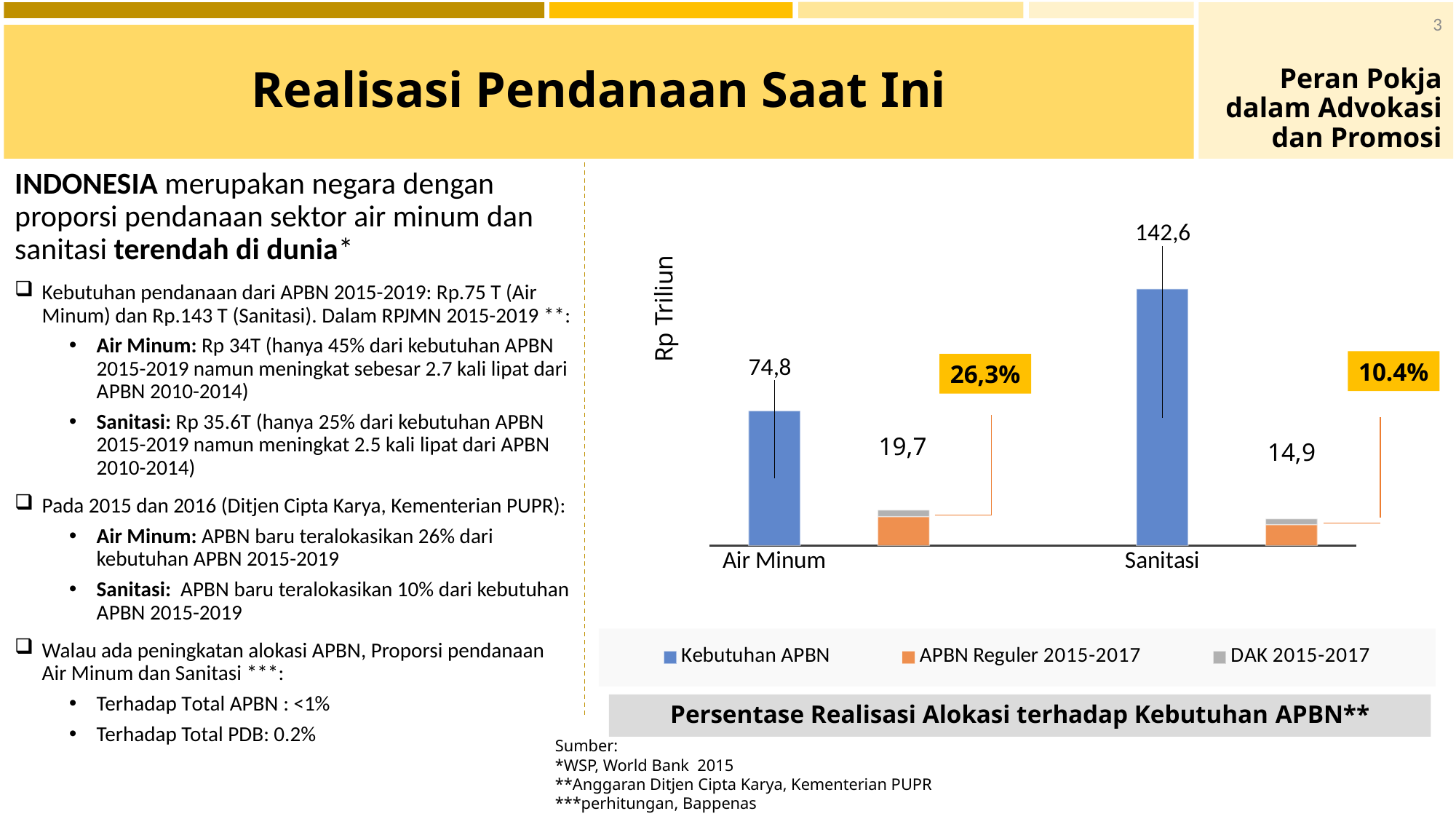
Which category has the lowest Kebutuhan APBN value? Air Minum Which series is shown in blue in the legend? Kebutuhan APBN What is the Kebutuhan APBN value for Sanitasi? 142,6 How many series does the legend list? 3 How many categories are shown on the x axis? 2 What is the difference between the Kebutuhan APBN values for Sanitasi and Air Minum? 67,8 What is the Kebutuhan APBN value for Air Minum? 74,8 What percentage is shown in the highlighted box next to the Sanitasi bars? 10.4% What percentage is shown in the highlighted box next to the Air Minum bars? 26,3% What unit is shown on the vertical axis label of the chart? Rp Triliun What kind of chart is shown on the slide? Bar chart Which category has the higher Kebutuhan APBN value, Air Minum or Sanitasi? Sanitasi